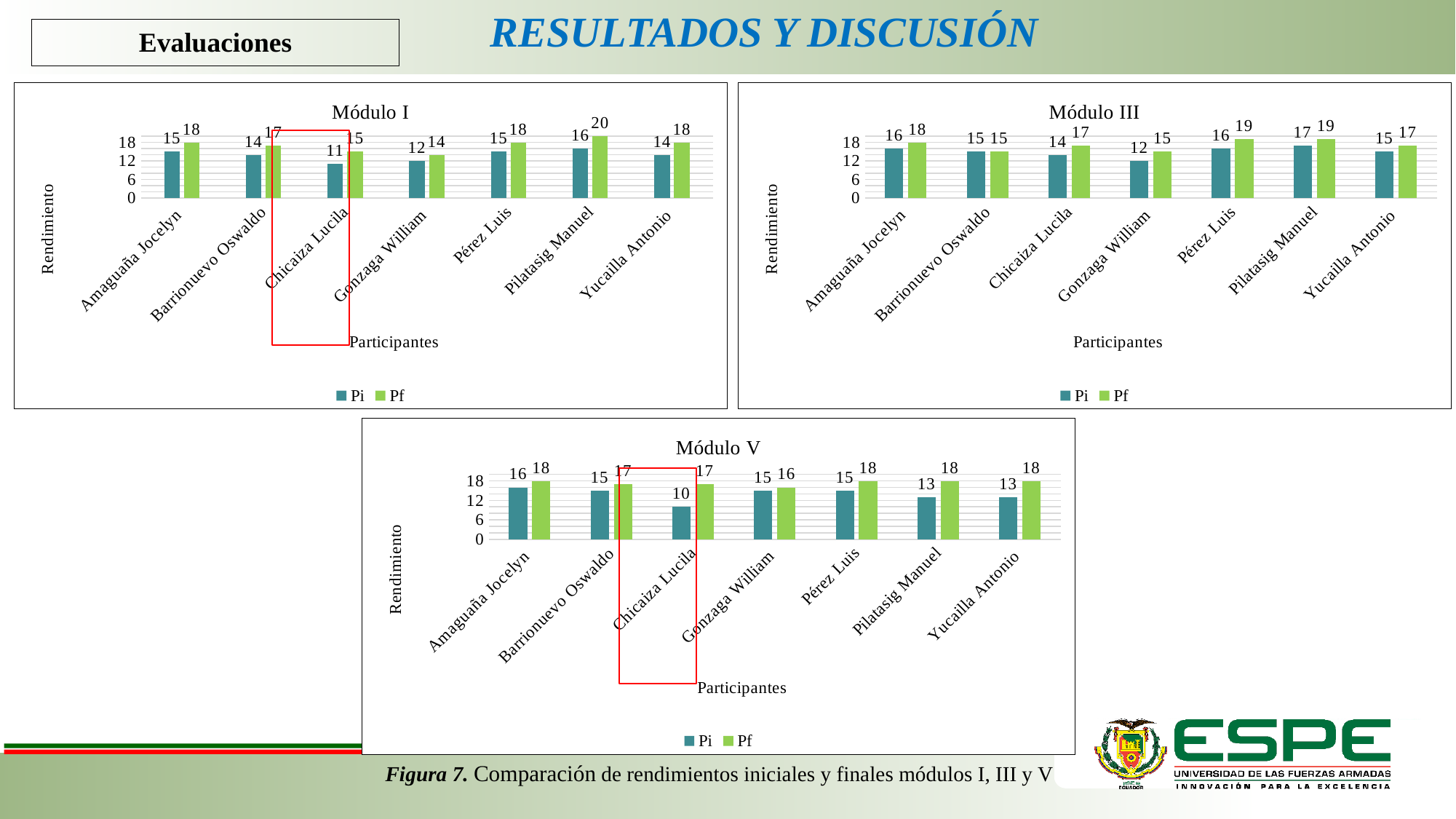
In the Módulo I chart, which participant has the lowest Pi value? Chicaiza Lucila In the Módulo III chart, which participant has the lowest Pi value? Gonzaga William What type of chart is the Módulo III chart? bar chart What is the label of the y axis on the Módulo V chart? Rendimiento In the Módulo V chart, what is the difference between the Pf and Pi values for Chicaiza Lucila? 7 How many series does the legend of the Módulo I chart list? 2 In the Módulo I chart, what is the difference between the Pf and Pi values for Chicaiza Lucila? 4 In the Módulo III chart, what is the Pi value for Pilatasig Manuel? 17 In the Módulo I chart, what is the Pf value for Pilatasig Manuel? 20 In the Módulo V chart, how many participants are shown on the x axis? 7 In the Módulo III chart, is the Pf value for Pérez Luis larger or smaller than the Pf value for Yucailla Antonio? larger In the Módulo V chart, what is the Pi value for Chicaiza Lucila? 10